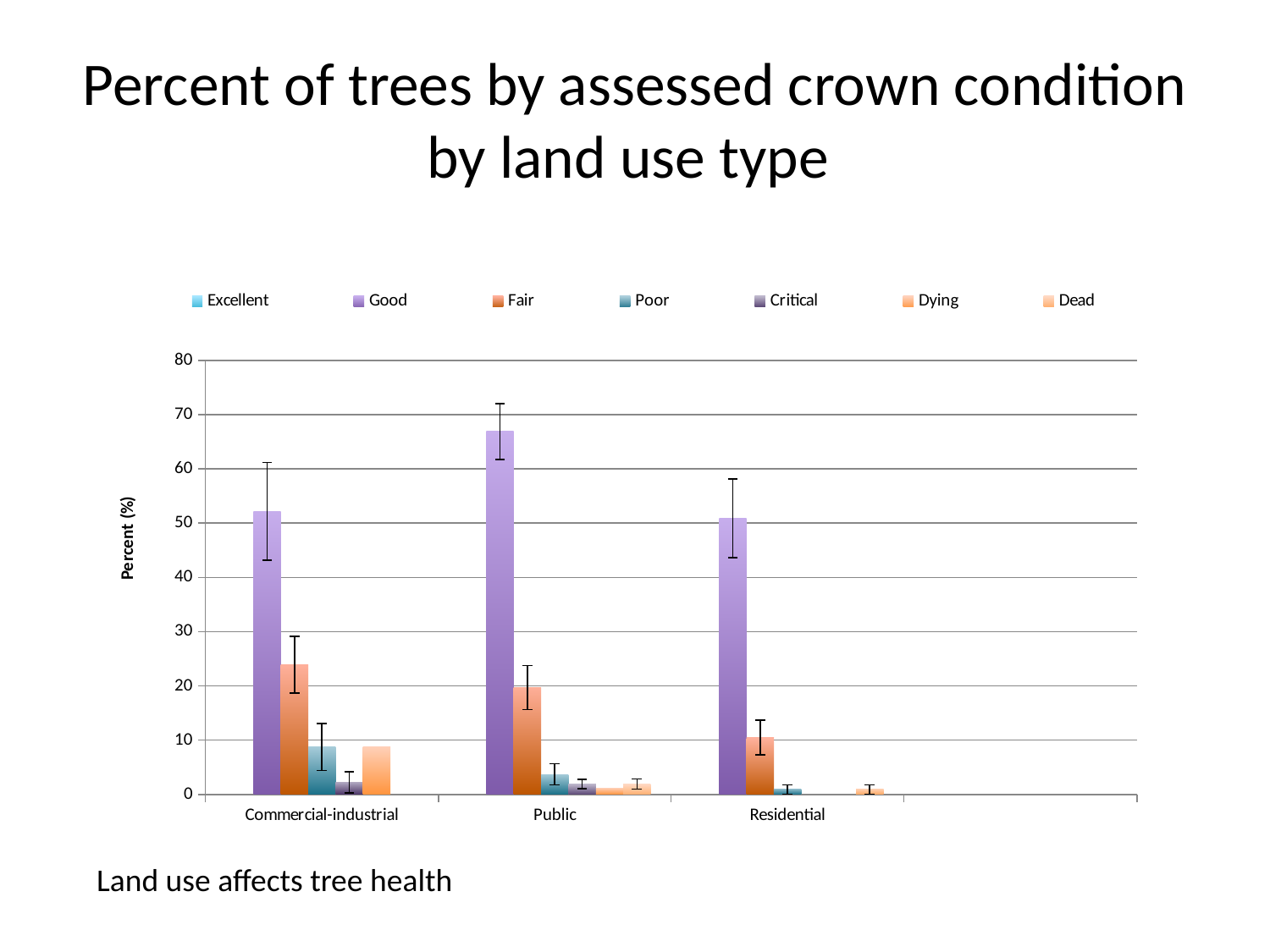
Which is larger, the Good value for Public or the Good value for Residential? Public Is the value for Good in Residential greater or less than 40? greater How many series does the legend list? 7 What kind of chart is shown on the slide? bar chart Is the value for Good in Public greater or less than 60? greater Which land use type has the highest value for Good? Public What is the label on the y axis? Percent (%) Is the value for Poor in Commercial-industrial greater or less than 20? less Which crown condition has the highest value for Public? Good How many land use types are shown on the x axis? 3 Which is larger, the Fair value for Commercial-industrial or the Fair value for Residential? Commercial-industrial